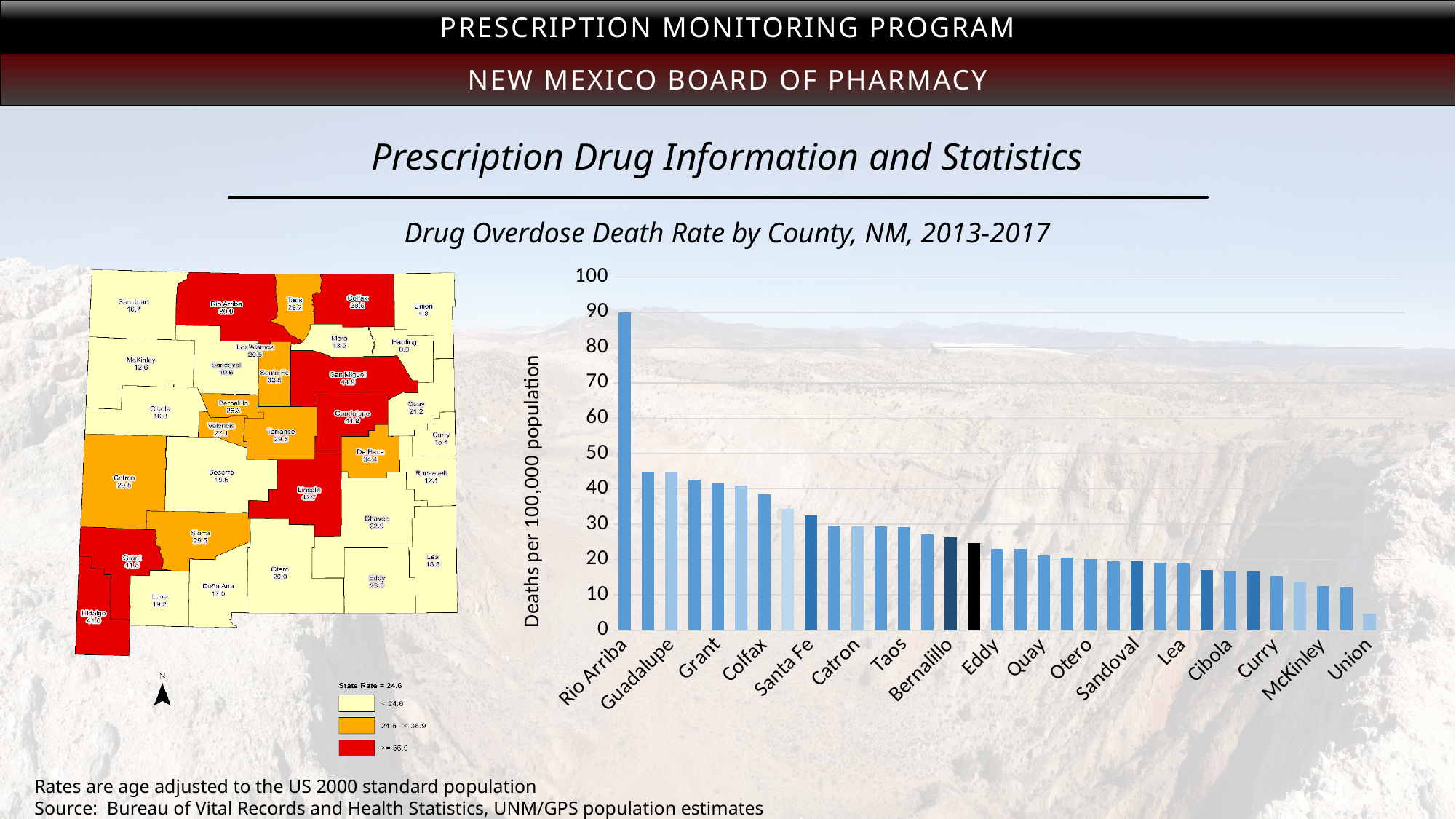
Which has a higher drug overdose death rate, Grant or Eddy? Grant Is the value for Bernalillo greater or less than 30? less Which has a higher drug overdose death rate, Santa Fe or Curry? Santa Fe Which county has the highest drug overdose death rate in the bar chart? Rio Arriba What kind of chart is used to show the drug overdose death rate by county? bar chart Is the value for McKinley greater or less than 20? less Which county has the lowest drug overdose death rate in the bar chart? Union Is the value for Rio Arriba greater or less than 80? greater What is the label on the vertical axis of the bar chart? Deaths per 100,000 population Do the values in the bar chart rise or fall from left to right? fall